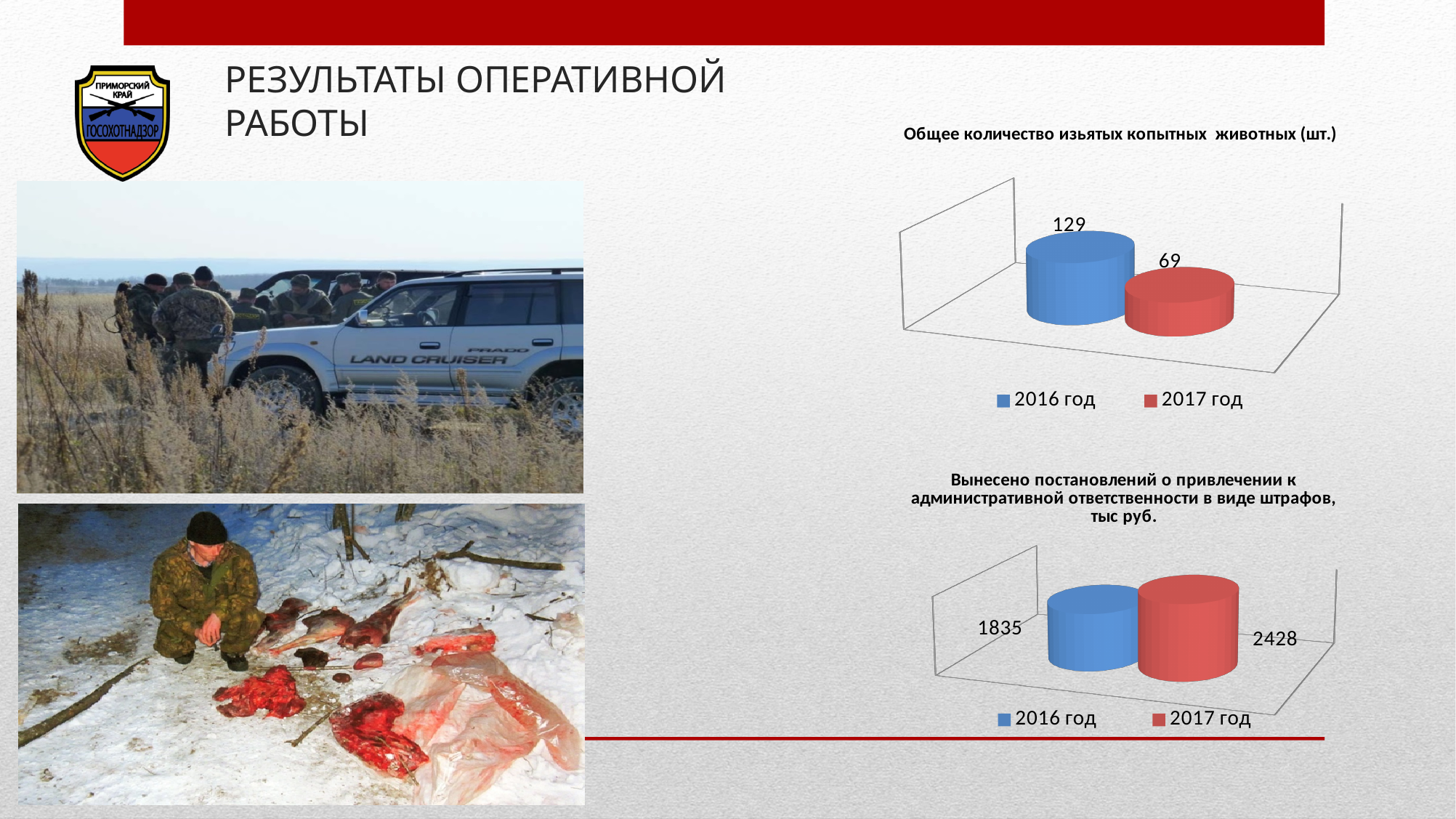
In the top chart (Общее количество изьятых копытных животных), which year has the higher value? 2016 год In the bottom chart (Вынесено постановлений ... в виде штрафов), which year has the lower value? 2016 год In the bottom chart (Вынесено постановлений ... в виде штрафов), what is the value for 2016 год? 1835 In the bottom chart (Вынесено постановлений ... в виде штрафов), is the value for 2017 год larger or smaller than the value for 2016 год? larger In the top chart (Общее количество изьятых копытных животных), what is the difference between the 2016 and 2017 values? 60 In the top chart (Общее количество изьятых копытных животных), what colour represents 2017 год? red In the top chart (Общее количество изьятых копытных животных), what is the value for 2017 год? 69 In the bottom chart (Вынесено постановлений ... в виде штрафов), what is the value for 2017 год? 2428 In the top chart (Общее количество изьятых копытных животных), what is the value for 2016 год? 129 In the bottom chart (Вынесено постановлений ... в виде штрафов), what is the difference between the 2017 and 2016 values? 593 In the top chart (Общее количество изьятых копытных животных), how many series does the legend list? 2 What kind of chart is the bottom chart (Вынесено постановлений ... в виде штрафов)? bar chart